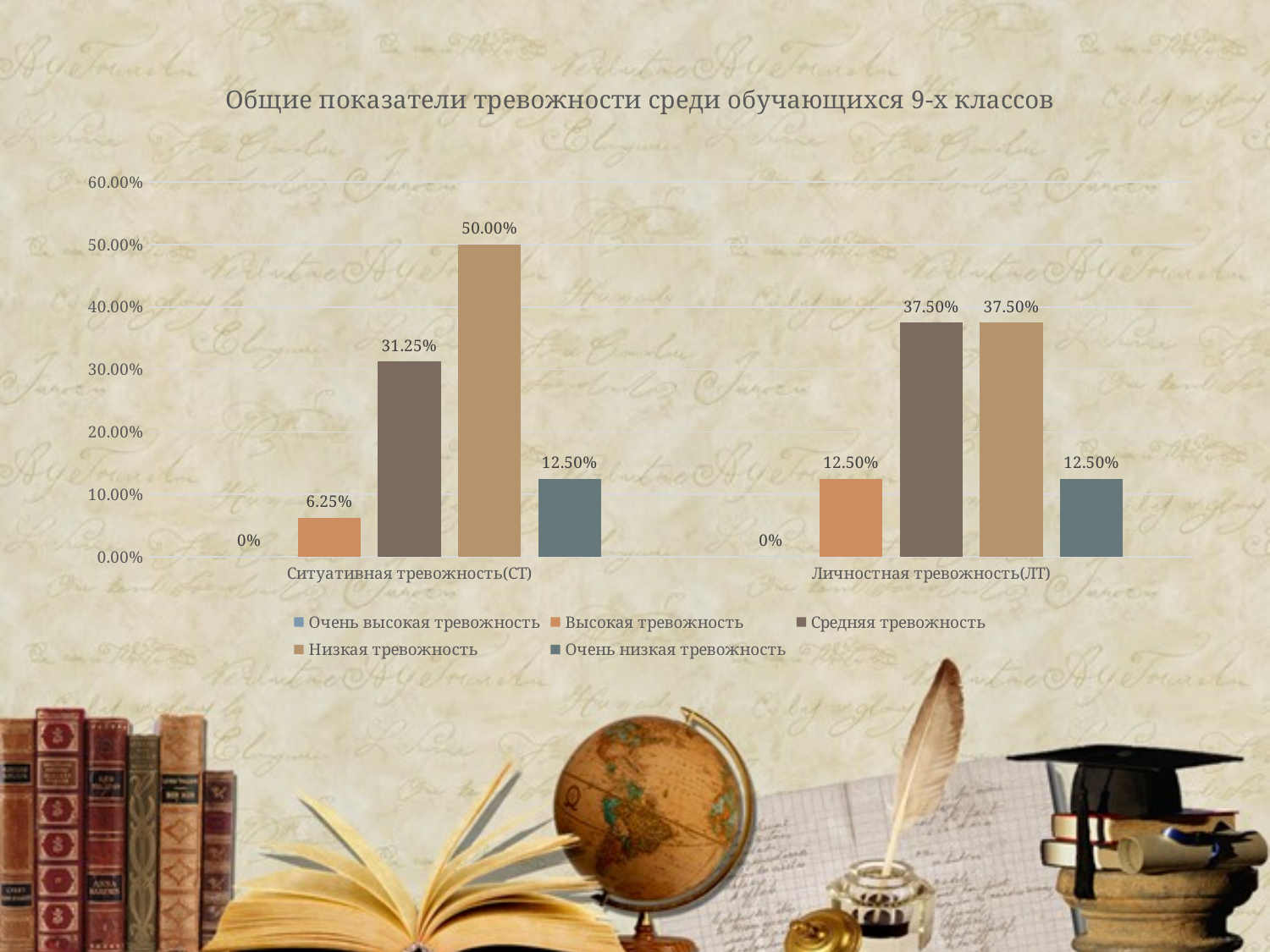
Which is larger: Средняя тревожность in Ситуативная тревожность(СТ) or Средняя тревожность in Личностная тревожность(ЛТ)? Личностная тревожность(ЛТ) What is the value for Очень высокая тревожность in the Личностная тревожность(ЛТ) category? 0% Which series has the highest value in the Ситуативная тревожность(СТ) category? Низкая тревожность Which series has the lowest value in the Ситуативная тревожность(СТ) category? Очень высокая тревожность What is the value for Средняя тревожность in the Личностная тревожность(ЛТ) category? 37.50% How many categories are shown on the x axis? 2 What is the difference between Низкая тревожность and Средняя тревожность in the Ситуативная тревожность(СТ) category? 18.75% What is the value for Высокая тревожность in the Ситуативная тревожность(СТ) category? 6.25% What type of chart is shown on the slide? Bar chart What is the value for Низкая тревожность in the Ситуативная тревожность(СТ) category? 50.00% How many series does the legend list? 5 What is the difference between Высокая тревожность in Личностная тревожность(ЛТ) and Высокая тревожность in Ситуативная тревожность(СТ)? 6.25%